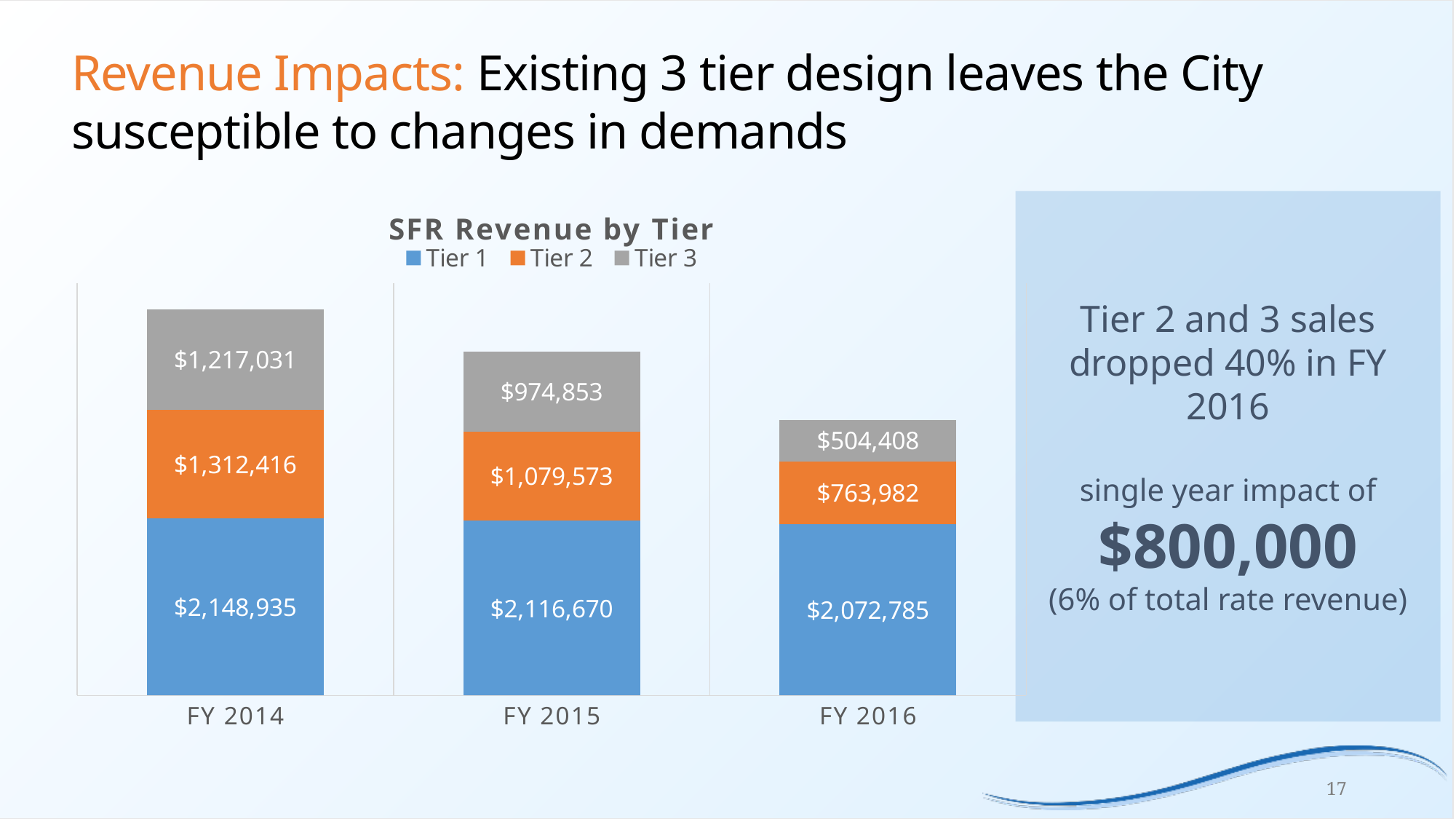
What is the Tier 1 value for FY 2015 in the SFR Revenue by Tier chart? $2,116,670 Which is larger: Tier 2 revenue in FY 2014 or Tier 3 revenue in FY 2014? Tier 2 revenue in FY 2014 What is the difference between the Tier 2 values for FY 2015 and FY 2016? $315,591 What kind of chart is SFR Revenue by Tier? Stacked bar chart What is the total SFR revenue for FY 2016 across all three tiers? $3,341,175 What is the Tier 2 value for FY 2014? $1,312,416 How many series does the chart legend list? 3 Which fiscal year has the highest Tier 3 revenue? FY 2014 What is the Tier 3 value for FY 2016? $504,408 Which fiscal year has the lowest Tier 2 revenue? FY 2016 How many fiscal years are shown on the x axis of the chart? 3 What is the difference between the Tier 3 values for FY 2014 and FY 2016? $712,623